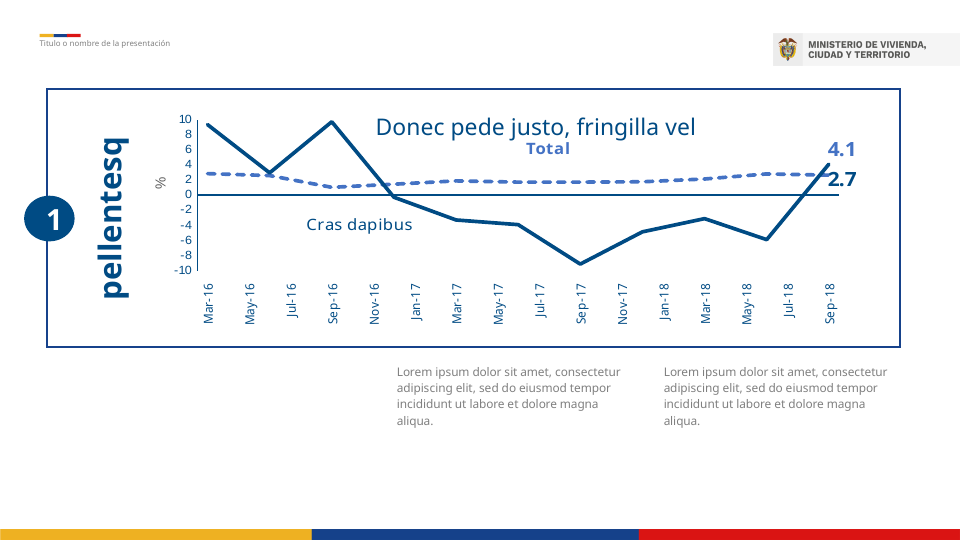
What is the title of the chart? Donec pede justo, fringilla vel Is the value of the solid line at Mar-16 greater or less than 6? greater What label is shown on the y axis? % At which date does the solid line reach its lowest point? Sep-17 What is the difference between the solid line and the dashed line at Sep-18? 1.4 What kind of chart is shown on the slide? line chart How many dates are labelled on the x axis? 16 Is the value of the solid line at Sep-17 greater or less than -6? less What is the value of the dashed line at Sep-18? 2.7 At Sep-18, which line has the higher value, the solid line or the dashed line? the solid line What is the value of the solid line at Sep-18? 4.1 Does the solid line rise or fall between Sep-16 and Sep-17? fall